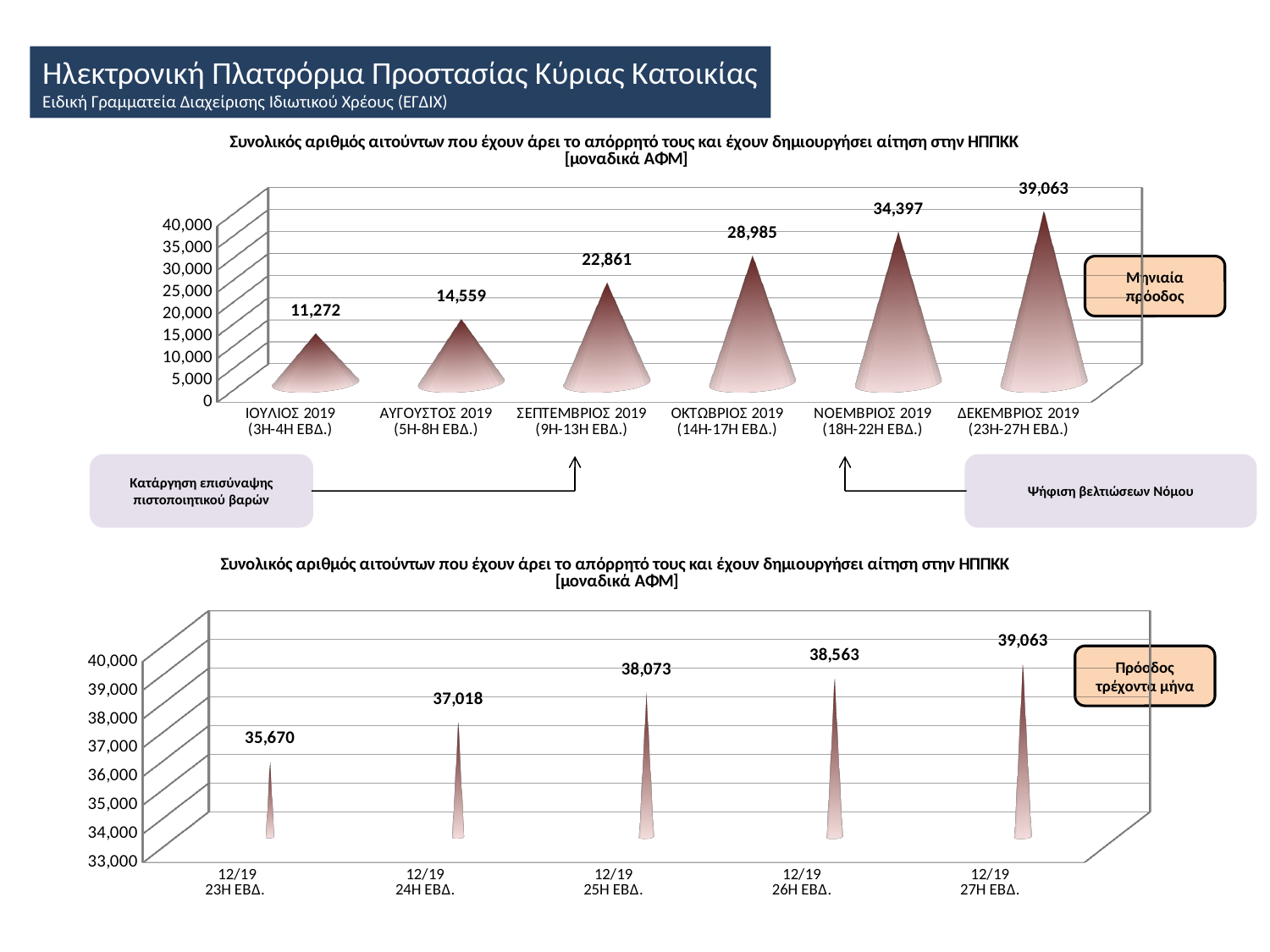
In the bottom chart, which week has the highest value? 12/19 27Η ΕΒΔ. In the bottom chart, how many weeks are plotted? 5 In the top chart, what is the value for ΔΕΚΕΜΒΡΙΟΣ 2019? 39,063 In the top chart, how many months are plotted? 6 In the top chart, what is the value for ΣΕΠΤΕΜΒΡΙΟΣ 2019? 22,861 In the bottom chart, what is the difference between the values for 24Η ΕΒΔ. and 23Η ΕΒΔ.? 1,348 In the bottom chart, what is the value for 12/19 26Η ΕΒΔ.? 38,563 In the bottom chart, what is the value for 12/19 24Η ΕΒΔ.? 37,018 In the top chart, do the values rise or fall from ΙΟΥΛΙΟΣ 2019 to ΔΕΚΕΜΒΡΙΟΣ 2019? rise In the top chart, what is the difference between the values for ΔΕΚΕΜΒΡΙΟΣ 2019 and ΝΟΕΜΒΡΙΟΣ 2019? 4,666 What kind of chart is the bottom chart? bar chart In the top chart, which month has the lowest value? ΙΟΥΛΙΟΣ 2019